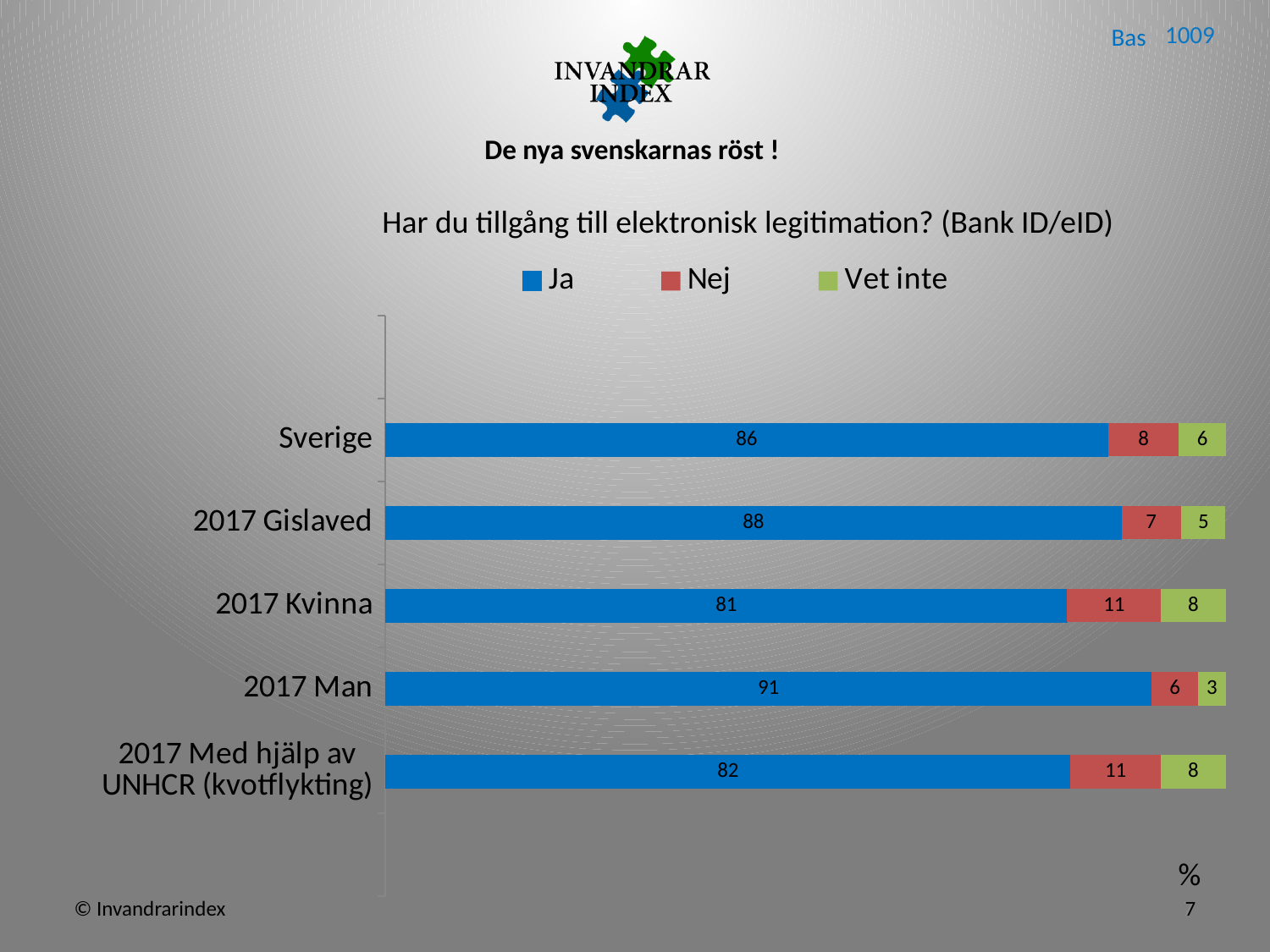
Which category has the highest value for "Ja"? 2017 Man What is the value for "Vet inte" for 2017 Man? 3 What is the value for "Ja" for Sverige? 86 What is the value for "Ja" for 2017 Med hjälp av UNHCR (kvotflykting)? 82 What is the value for "Nej" for 2017 Kvinna? 11 Which category has the lowest value for "Ja"? 2017 Kvinna How many categories are shown on the chart? 5 What is the difference between the "Ja" values for 2017 Man and 2017 Kvinna? 10 What is the total of the stacked bar for 2017 Gislaved? 100 What kind of chart is shown on the slide? Stacked bar chart Which is larger, the "Nej" value for Sverige or for 2017 Gislaved? Sverige How many series does the legend list? 3